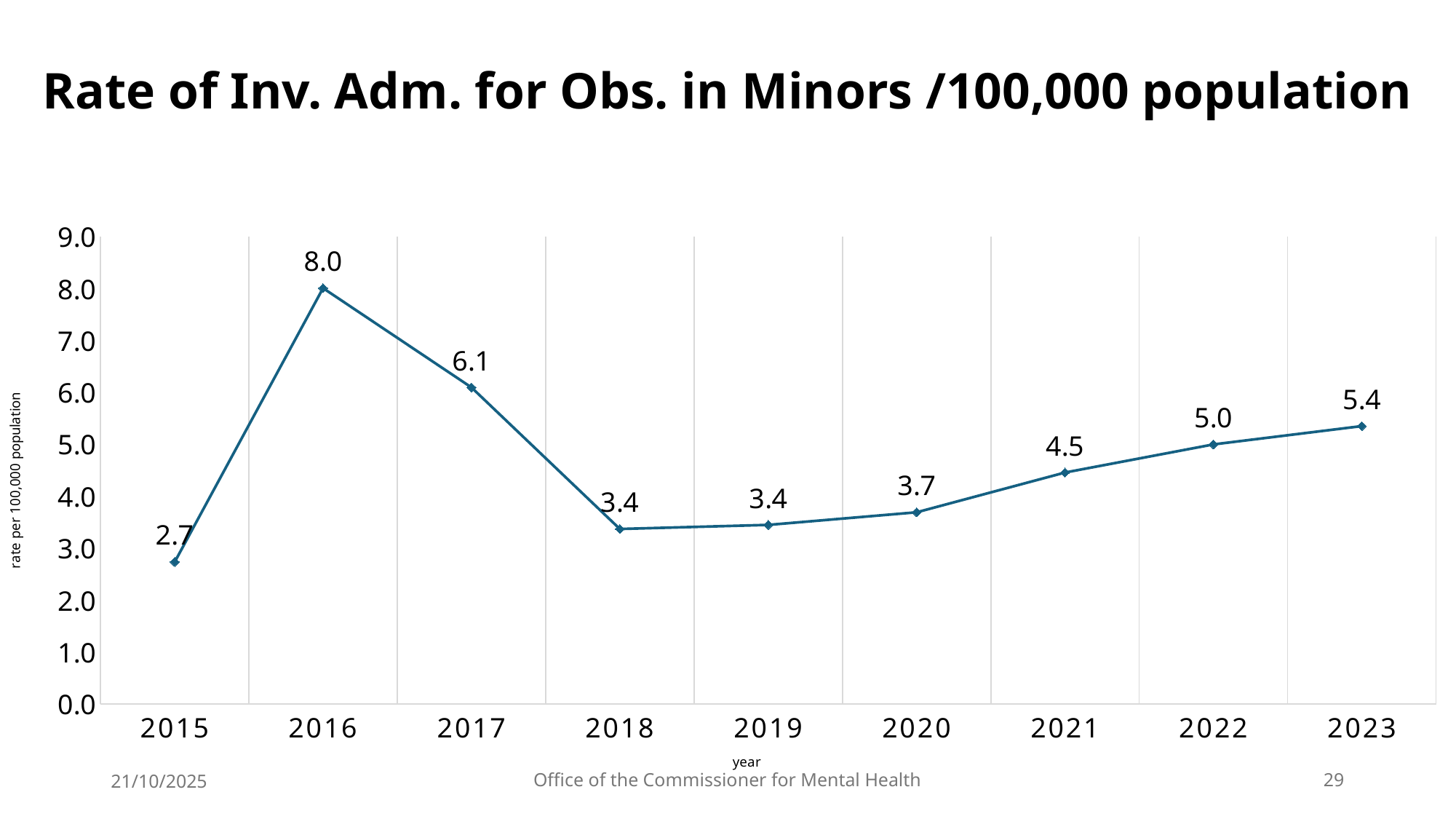
What is the label of the y axis? rate per 100,000 population Which year has the lowest rate? 2015 Is the value for 2022 greater or less than 4.0? greater What is the value plotted for 2023? 5.4 What is the rate of involuntary admissions for observation in minors per 100,000 population in 2016? 8.0 What is the difference between the 2016 value and the 2017 value? 1.9 What kind of chart is shown on the slide? line chart What is the value plotted for 2015? 2.7 Do the values rise or fall from 2018 to 2023? rise Which year has the highest rate? 2016 How many years are plotted on the x axis? 9 Which year has the larger value, 2021 or 2020? 2021